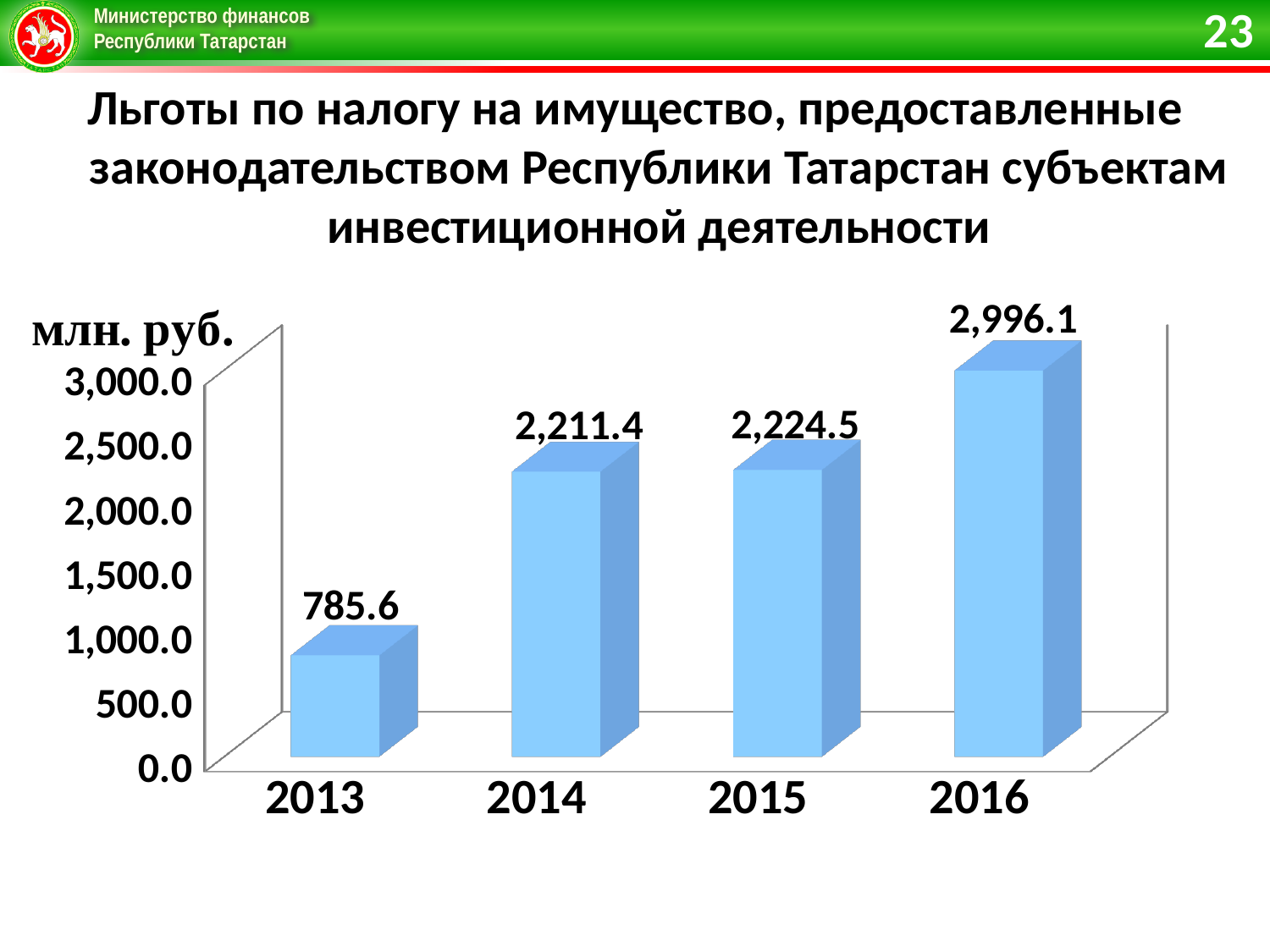
What is the value for 2013? 785.6 Which year has the lowest value? 2013 What unit is indicated for the values on the chart? млн. руб. What is the value for 2014? 2,211.4 What kind of chart is shown on the slide? bar chart What is the value for 2016? 2,996.1 What is the difference between the values for 2016 and 2013? 2,210.5 Which year has the highest value? 2016 Which is larger, the value for 2014 or the value for 2016? 2016 What is the difference between the values for 2015 and 2014? 13.1 How many years are shown on the x axis? 4 What is the value for 2015? 2,224.5